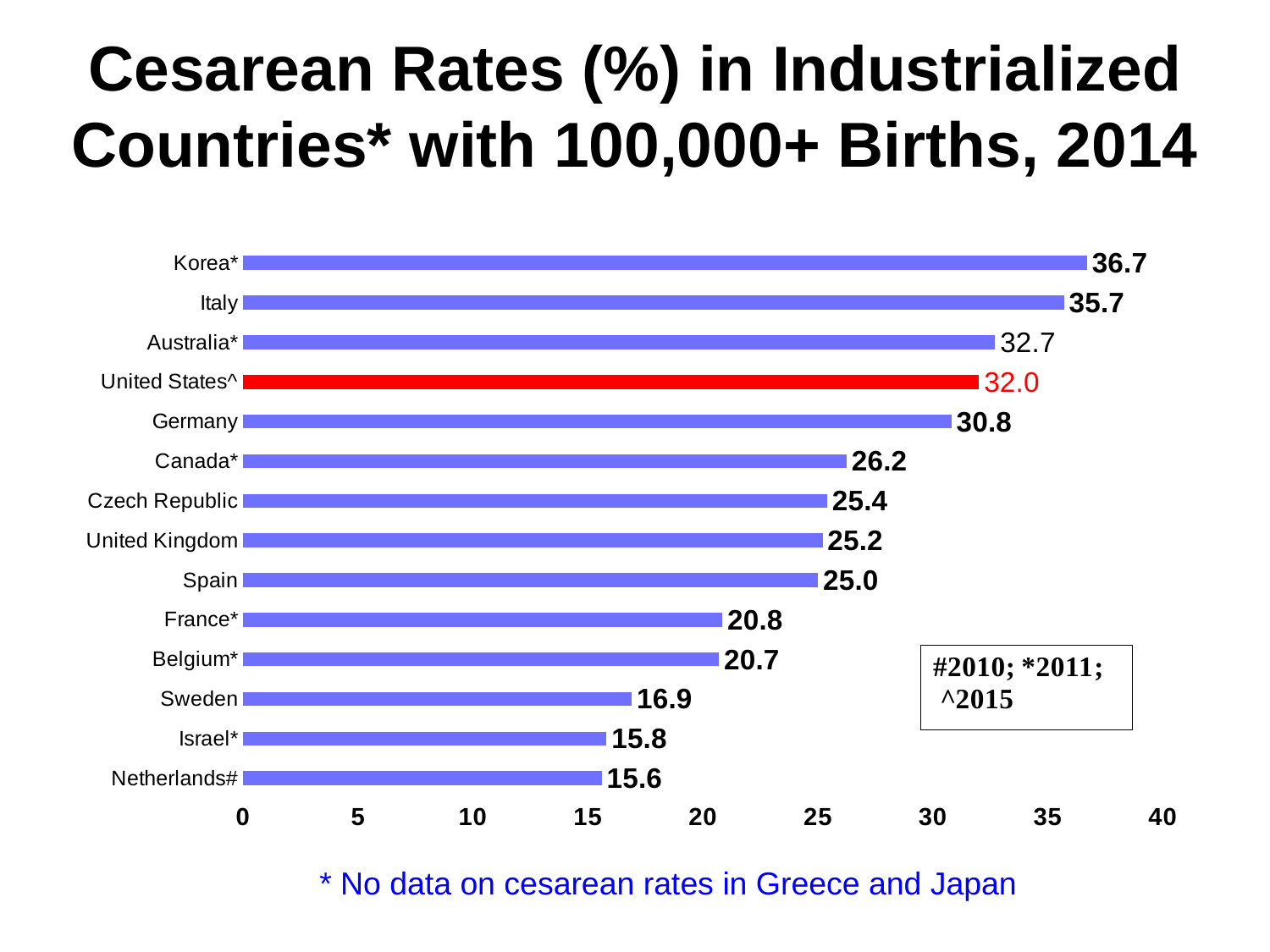
Which country has the highest cesarean rate? Korea* What is the difference between the cesarean rates of Korea* and Italy? 1.0 What is the cesarean rate for the United States^? 32.0 Is the cesarean rate for Spain greater or less than 20? greater What is the cesarean rate for Sweden? 16.9 Which country's bar is coloured red? United States^ Which country has the lowest cesarean rate? Netherlands# Which has a higher cesarean rate, Australia* or Germany? Australia* What is the cesarean rate for Germany? 30.8 What kind of chart is shown on the slide? Bar chart What is the difference between the cesarean rates of Canada* and France*? 5.4 How many countries are shown in the chart? 14